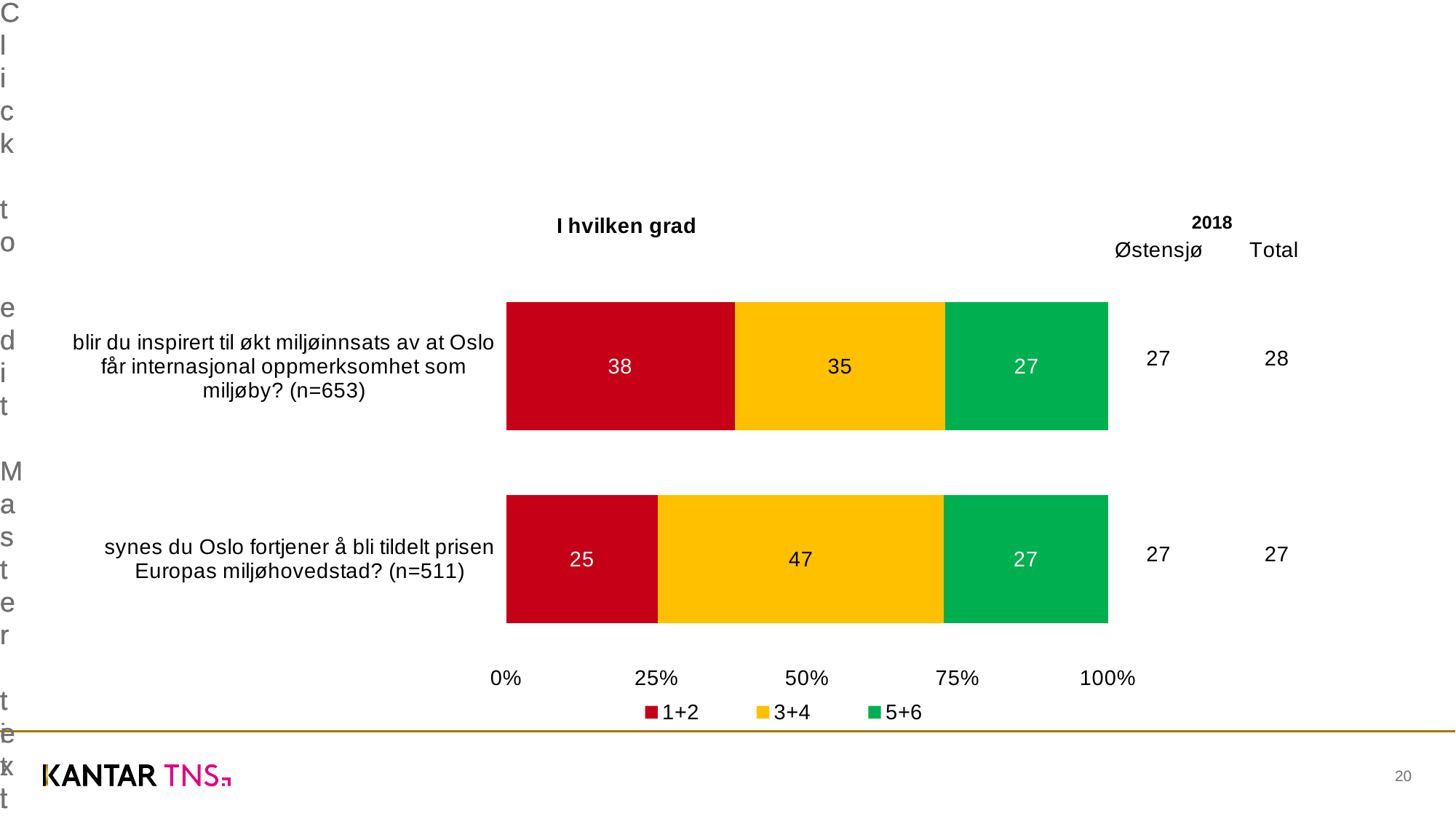
How many series does the legend list? 3 What kind of chart is shown on the slide? Stacked bar chart What is the value of the 5+6 segment for 'synes du Oslo fortjener å bli tildelt prisen Europas miljøhovedstad? (n=511)'? 27 What is the title of the chart? I hvilken grad What is the value of the 1+2 segment for 'blir du inspirert til økt miljøinnsats av at Oslo får internasjonal oppmerksomhet som miljøby? (n=653)'? 38 Which segment is the smallest in the bar for 'blir du inspirert til økt miljøinnsats av at Oslo får internasjonal oppmerksomhet som miljøby? (n=653)'? 5+6 How many categories (bars) are plotted in the chart? 2 What colour is used for the 1+2 series in the chart? Red Which segment is the largest in the bar for 'synes du Oslo fortjener å bli tildelt prisen Europas miljøhovedstad? (n=511)'? 3+4 What is the value of the 3+4 segment for 'synes du Oslo fortjener å bli tildelt prisen Europas miljøhovedstad? (n=511)'? 47 Which bar has the larger 3+4 value: 'blir du inspirert til økt miljøinnsats...' (n=653) or 'synes du Oslo fortjener å bli tildelt prisen...' (n=511)? synes du Oslo fortjener å bli tildelt prisen Europas miljøhovedstad? (n=511) What is the difference between the 1+2 values of the two bars? 13